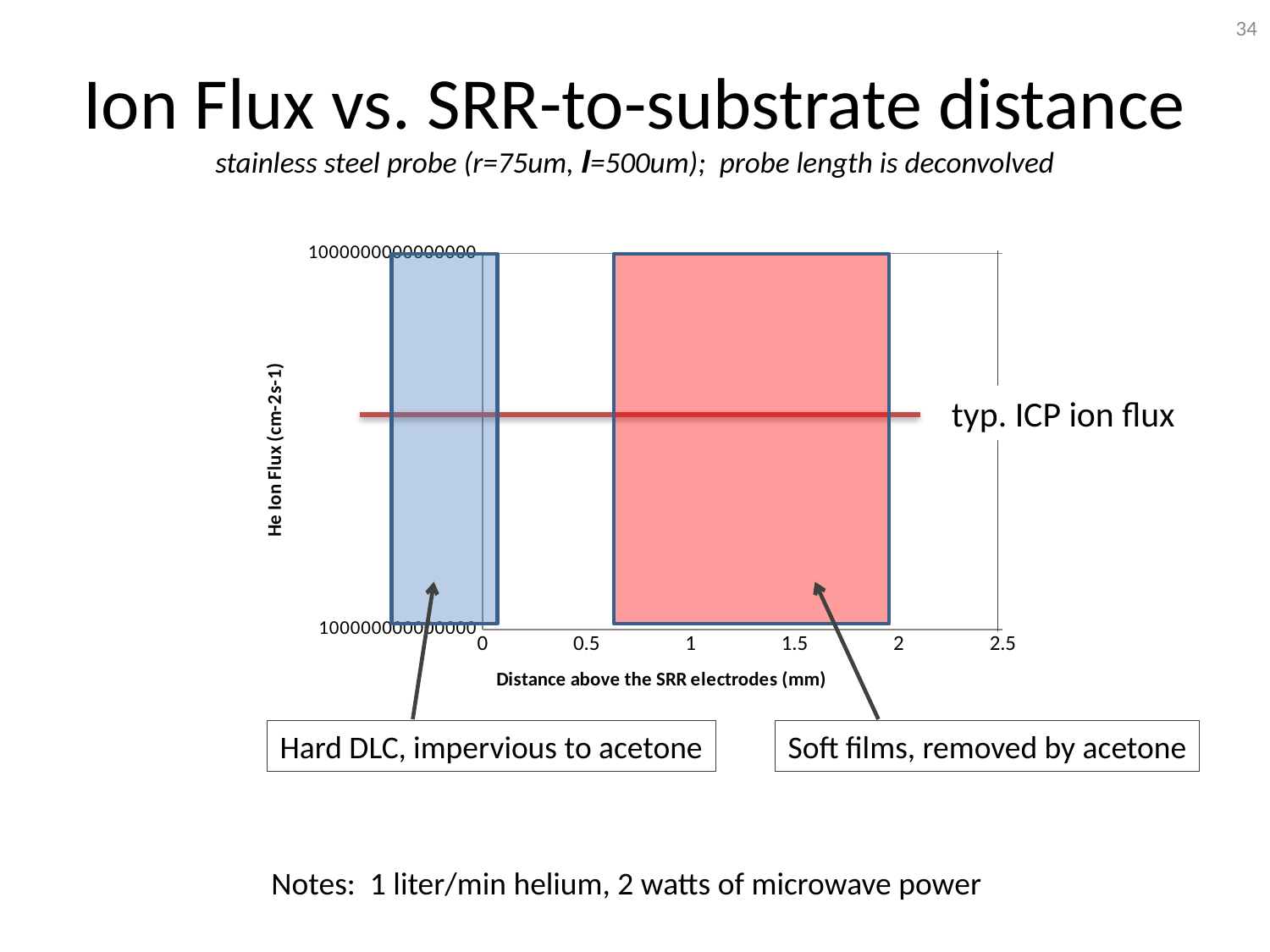
What label is attached by an arrow to the red shaded region of the chart? Soft films, removed by acetone What does the horizontal red line on the chart represent, according to its label? typ. ICP ion flux What is the title of the x axis of the chart? Distance above the SRR electrodes (mm) What is the lowest tick value shown on the y axis of the chart? 100000000000000 What label is attached by an arrow to the blue shaded region of the chart? Hard DLC, impervious to acetone What is the highest tick value shown on the y axis of the chart? 1000000000000000 What is the title of the y axis of the chart? He Ion Flux (cm-2s-1) What is the largest value shown on the x axis of the chart? 2.5 How many tick values are labelled on the x axis of the chart? 6